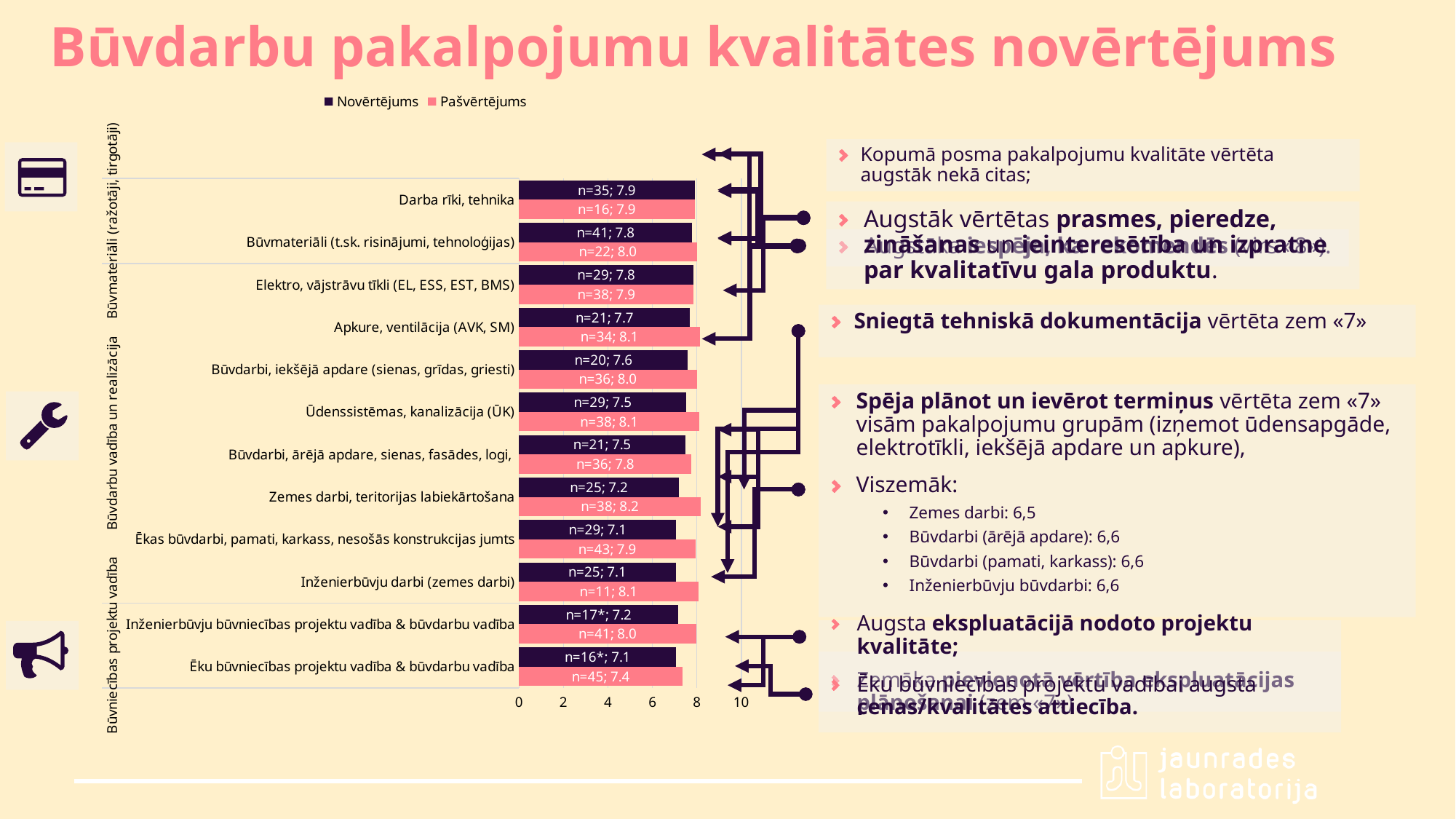
What is the Pašvērtējums value for 'Zemes darbi, teritorijas labiekārtošana'? 8.2 How many series does the chart legend list? 2 What is the difference between the Pašvērtējums and Novērtējums values for 'Zemes darbi, teritorijas labiekārtošana'? 1.0 Which category has the lowest Pašvērtējums value? Ēku būvniecības projektu vadība & būvdarbu vadība Which is larger for 'Apkure, ventilācija (AVK, SM)': the Novērtējums value or the Pašvērtējums value? Pašvērtējums What kind of chart is shown on the slide? bar chart How many categories are plotted on the chart? 12 Which category has the highest Pašvērtējums value? Zemes darbi, teritorijas labiekārtošana Which series is shown in pink in the legend? Pašvērtējums What is the data label for the Novērtējums bar of 'Darba rīki, tehnika'? n=35; 7.9 What is the n value shown for the Pašvērtējums bar of 'Inženierbūvju darbi (zemes darbi)'? n=11 What is the Novērtējums value for 'Ēku būvniecības projektu vadība & būvdarbu vadība'? 7.1